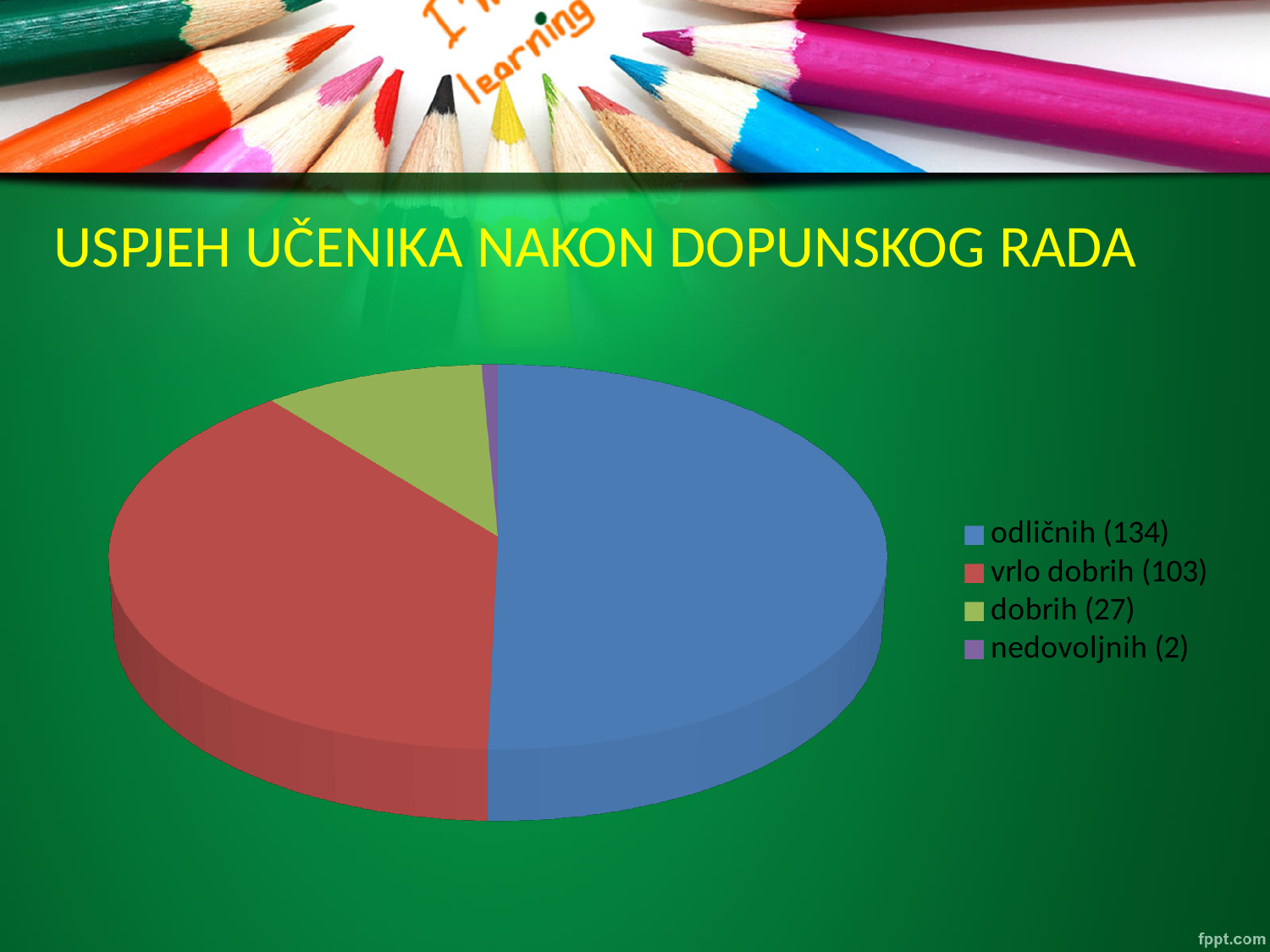
What is the value for vrlo dobrih? 103 Which category has the smallest slice of the pie? nedovoljnih What is the value for nedovoljnih? 2 How many categories does the pie chart have? 4 Which is larger, the value for dobrih or the value for nedovoljnih? dobrih What is the difference between the values for odličnih and vrlo dobrih? 31 What is the value for odličnih? 134 What is the title of the chart on the slide? USPJEH UČENIKA NAKON DOPUNSKOG RADA What kind of chart is shown on the slide? pie chart What colour is the slice for vrlo dobrih? red What is the value for dobrih? 27 Which category has the largest slice of the pie? odličnih